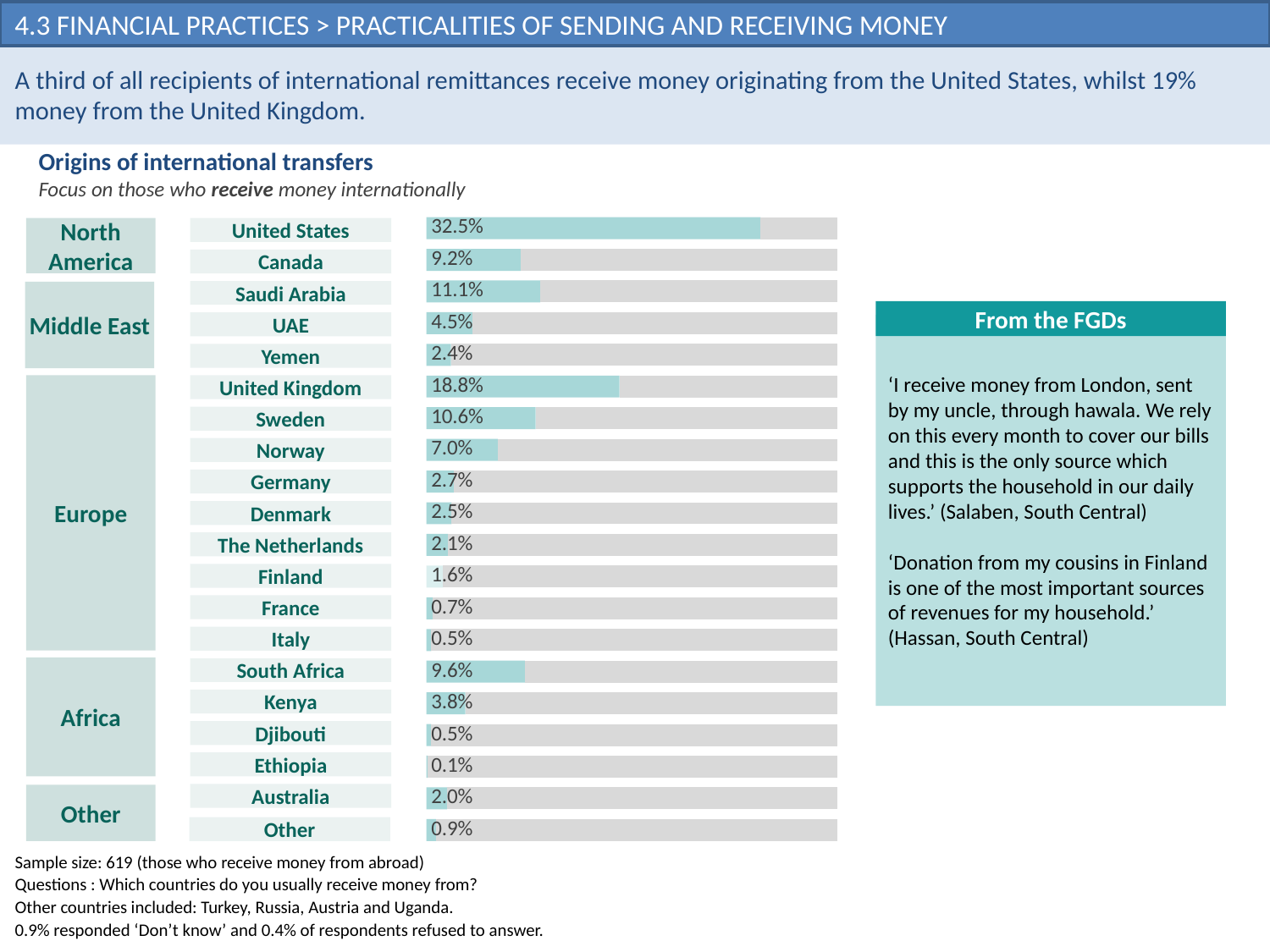
What is the difference between the values for the United States and the United Kingdom? 13.7% What percentage of recipients receive money from the United States? 32.5% Which country has the highest value in the chart? United States What is the difference between the values for Sweden and Norway? 3.6% What is the value shown for South Africa? 9.6% What is the value shown for Saudi Arabia? 11.1% How many countries/categories are plotted in the chart? 20 Which has a larger value, Kenya or UAE? UAE What is the title of the chart? Origins of international transfers Which has a larger value, Canada or South Africa? South Africa Which country has the lowest value in the chart? Ethiopia What type of chart is used to show the origins of international transfers? Bar chart